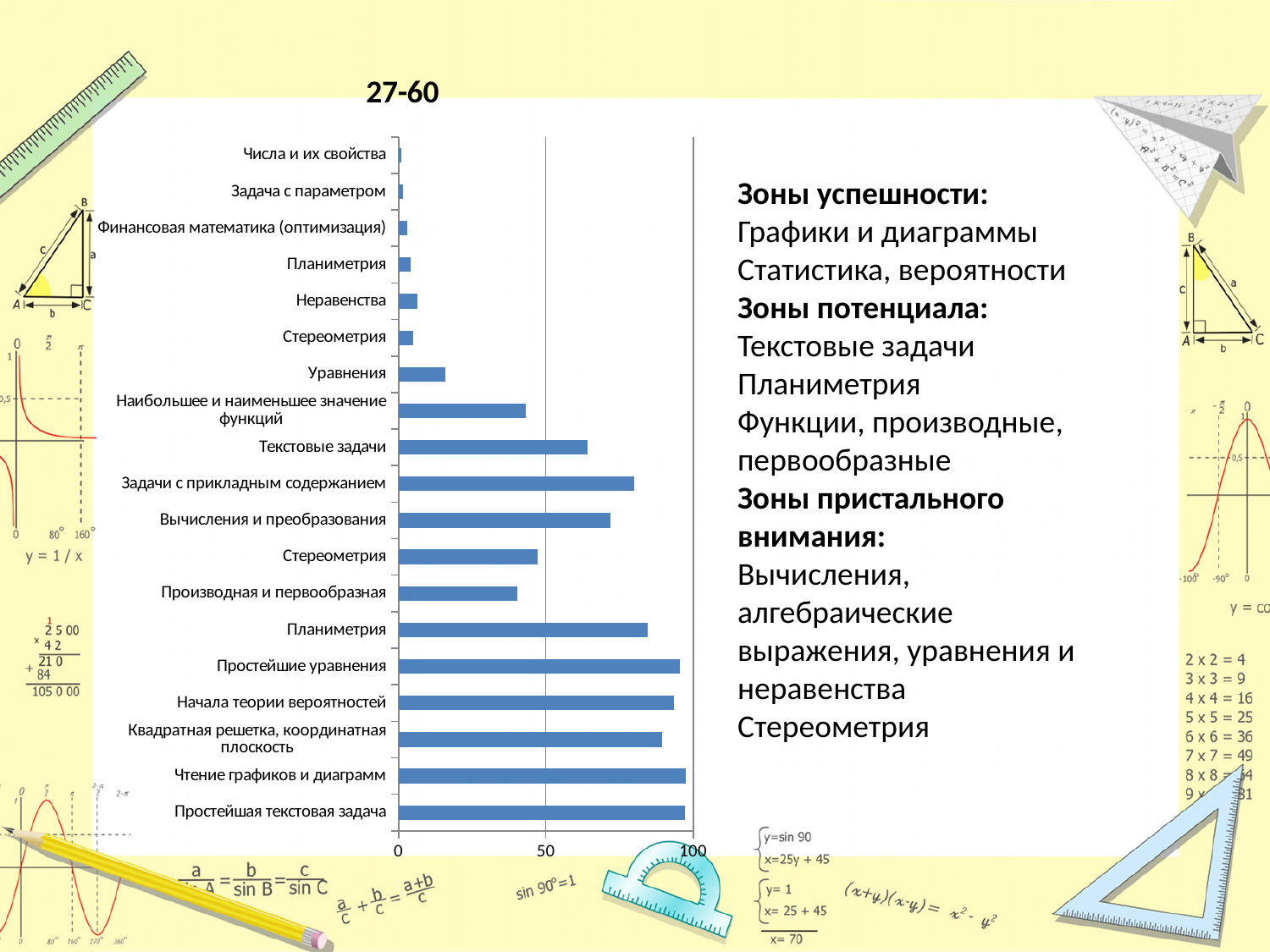
How many categories are plotted in the bar chart? 19 Which is larger, the value for Уравнения or the value for Неравенства? Уравнения Which category has the lowest value in the bar chart? Числа и их свойства What colour are the bars in the chart? blue Is the value for Текстовые задачи greater or less than 50? greater What kind of chart is shown on the slide? bar chart Which is larger, the value for Текстовые задачи or the value for Производная и первообразная? Текстовые задачи Is the value for Наибольшее и наименьшее значение функций greater or less than 50? less Which is larger, the value for Задачи с прикладным содержанием or the value for Вычисления и преобразования? Задачи с прикладным содержанием Is the value for Простейшие уравнения greater or less than 50? greater